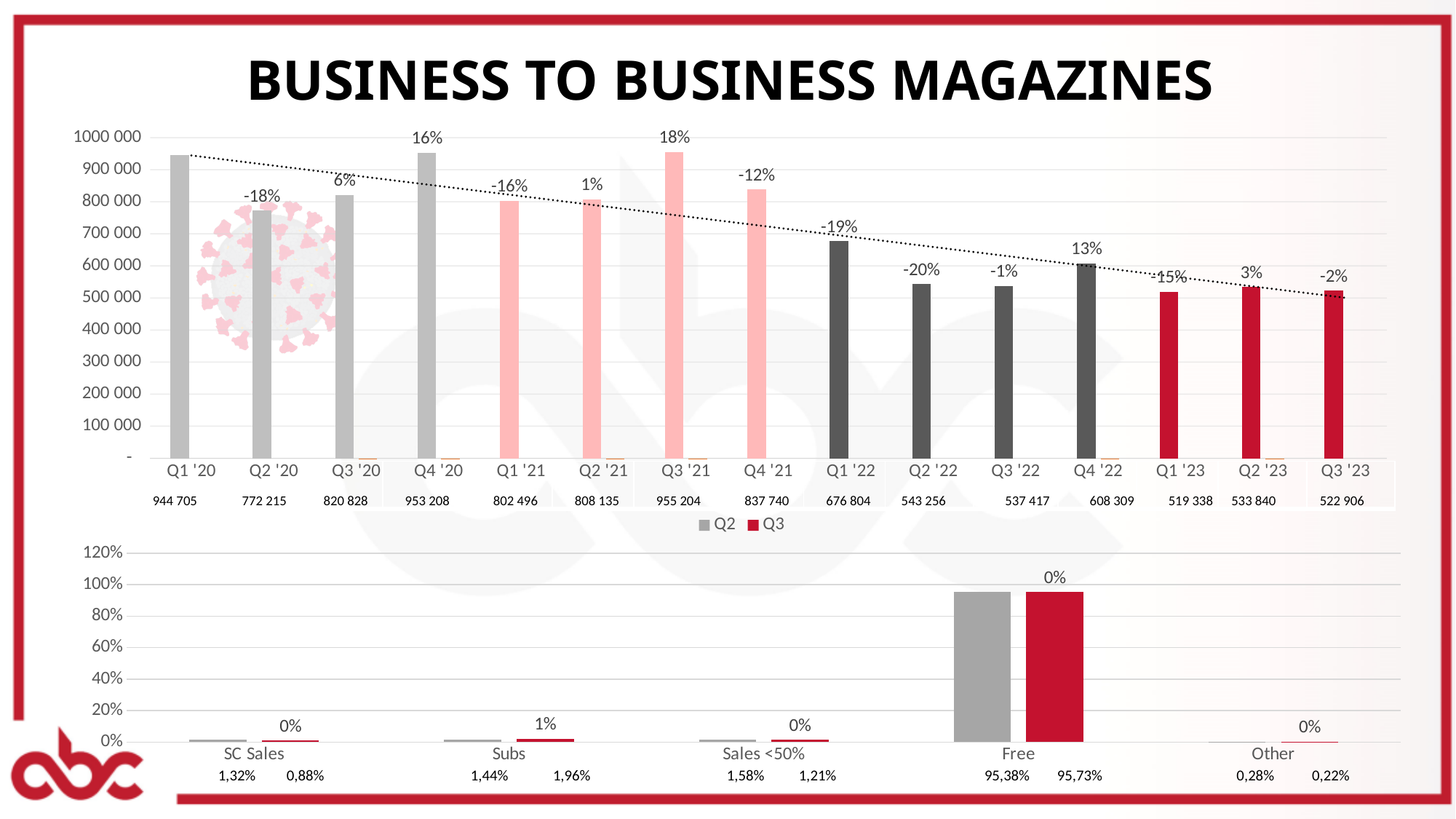
In the top chart, what is the difference between the values for Q1 '20 and Q3 '23? 421 799 In the top chart, what percentage change is labelled above the Q2 '22 bar? -20% In the top chart, what is the value for Q3 '21? 955 204 In the top chart, what is the value for Q1 '23? 519 338 In the top chart, do the values generally rise or fall from Q1 '20 to Q3 '23? fall In the top chart, which quarter has the highest value? Q3 '21 In the top chart, which quarter has the lowest value? Q1 '23 In the top chart, which is larger, the value for Q4 '22 or the value for Q3 '22? Q4 '22 In the bottom chart, what is the Q3 value for Free? 95,73% In the top chart, how many quarters are plotted? 15 How many series does the legend list? 2 In the bottom chart, which category has the highest values? Free